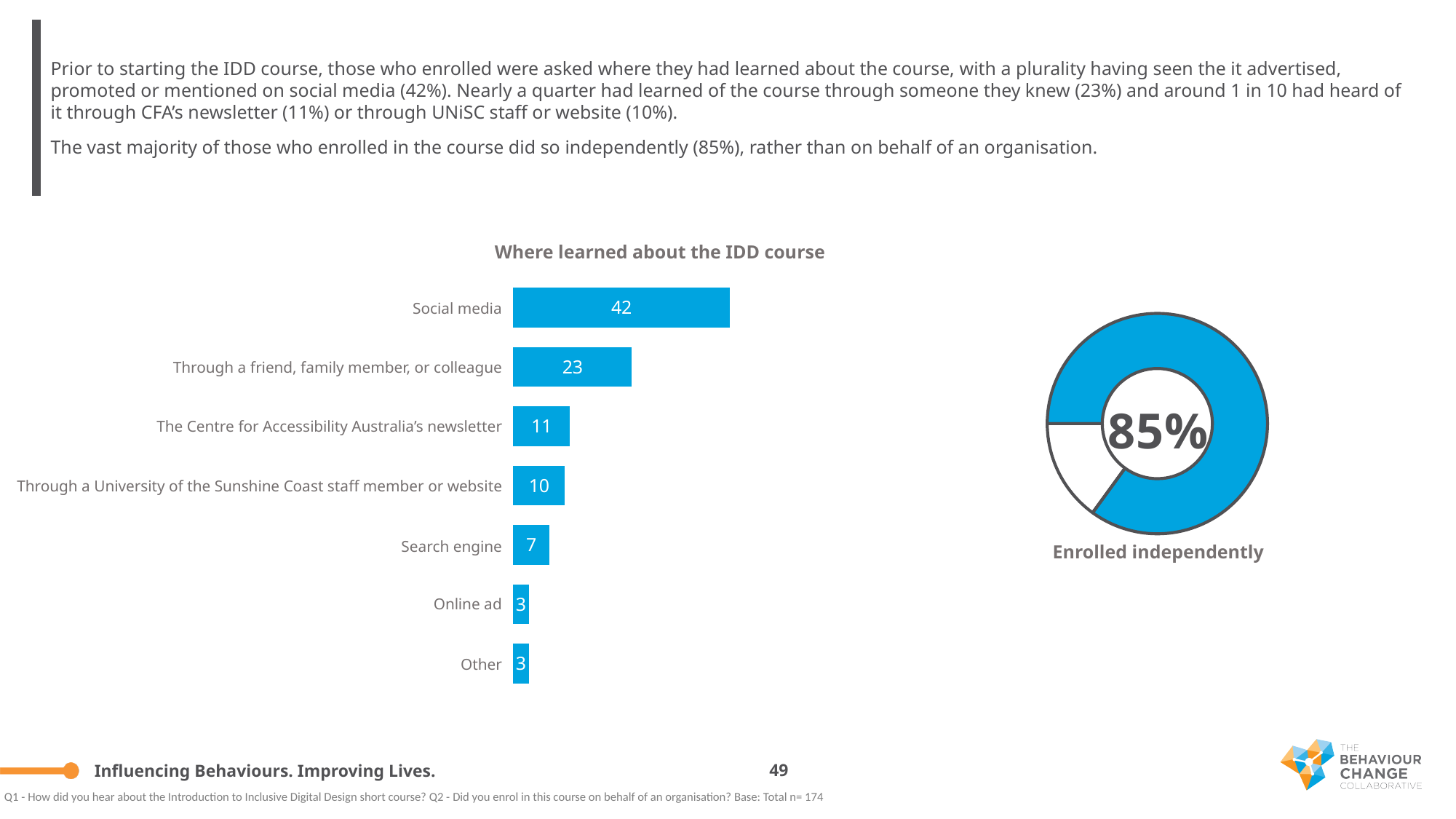
In the 'Where learned about the IDD course' chart, what is the value for Social media? 42 In the donut chart on the right, what percentage enrolled independently? 85% In the 'Where learned about the IDD course' chart, what is the value for 'The Centre for Accessibility Australia's newsletter'? 11 In the 'Where learned about the IDD course' chart, what is the difference between Search engine and Online ad? 4 In the 'Where learned about the IDD course' chart, what is the value for 'Through a friend, family member, or colleague'? 23 In the 'Where learned about the IDD course' chart, which category has the highest value? Social media What kind of chart is 'Where learned about the IDD course'? Bar chart What kind of chart is the 'Enrolled independently' chart on the right? Donut chart How many categories are shown in the 'Where learned about the IDD course' chart? 7 In the 'Where learned about the IDD course' chart, what is the difference between Social media and 'Through a friend, family member, or colleague'? 19 In the 'Where learned about the IDD course' chart, what is the value for Search engine? 7 In the 'Where learned about the IDD course' chart, which is larger: 'The Centre for Accessibility Australia's newsletter' or 'Through a University of the Sunshine Coast staff member or website'? The Centre for Accessibility Australia's newsletter